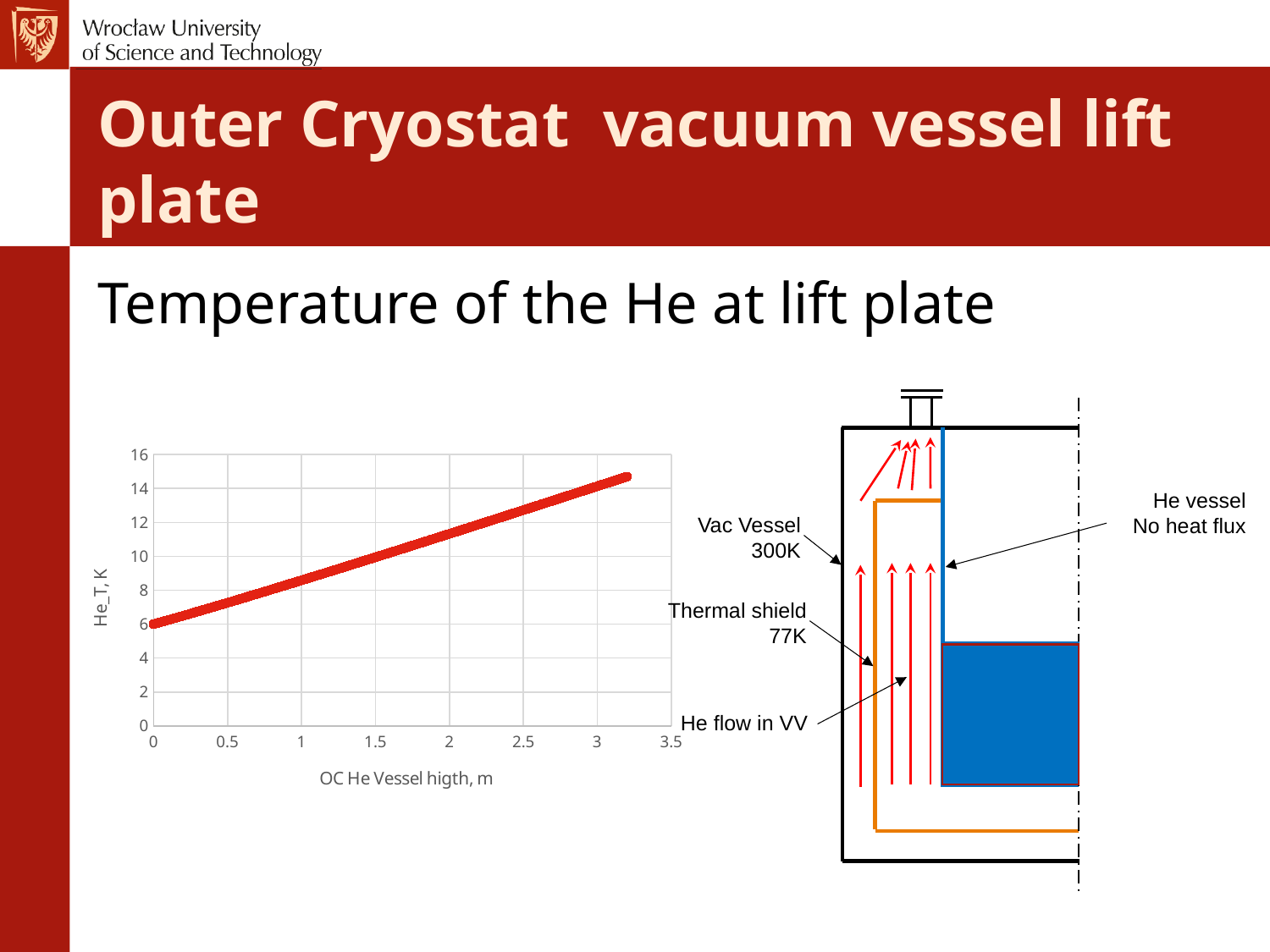
Is the He temperature at a vessel height of 1 m greater or less than 10 K? less Is the He temperature at a vessel height of 2 m greater or less than 12 K? less Does the He temperature rise or fall as the OC He Vessel height increases? rises Is the He temperature at a vessel height of 0 m greater or less than 8 K? less What kind of chart is shown on the slide? line chart What is the label of the vertical axis of the chart? He_T, K What is the maximum value shown on the vertical axis of the chart? 16 What is the label of the horizontal axis of the chart? OC He Vessel higth, m